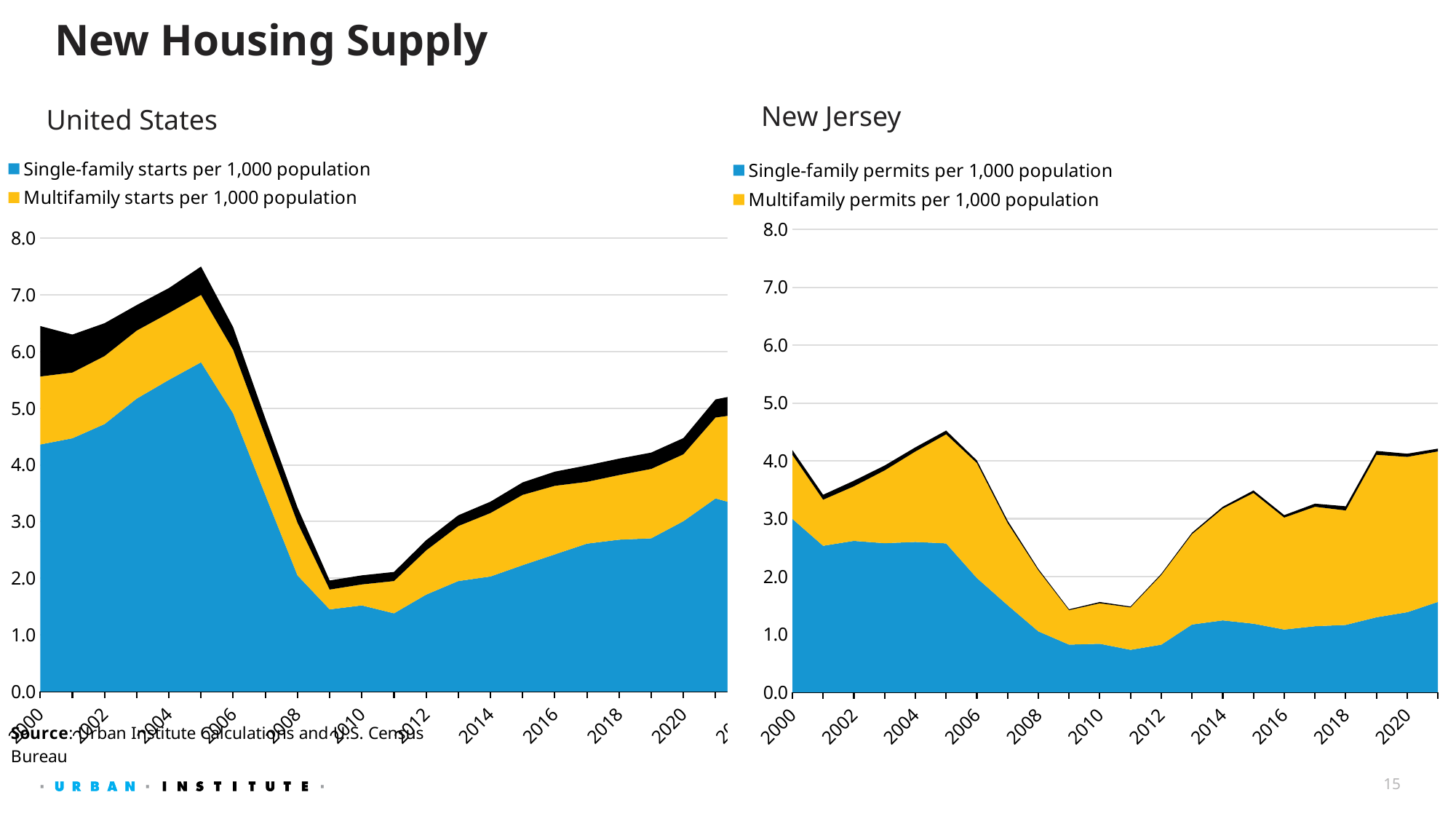
In the United States chart, do single-family starts rise or fall between 2005 and 2009? fall In the New Jersey chart, is the combined total of single-family and multifamily permits in 2009 greater or less than 2.0? less In the New Jersey chart, do single-family permits rise or fall between 2012 and 2021? rise What kind of chart is the United States chart? stacked area chart What is the title of the slide? New Housing Supply In the United States chart, is the single-family starts value in 2009 greater or less than 2.0? less In the United States chart, in which year do single-family starts per 1,000 population peak? 2005 How many series does the legend of the New Jersey chart list? 2 In the United States chart, which year has the higher single-family starts value, 2005 or 2009? 2005 In the New Jersey chart, is the single-family permits value in 2010 greater or less than 1.0? less